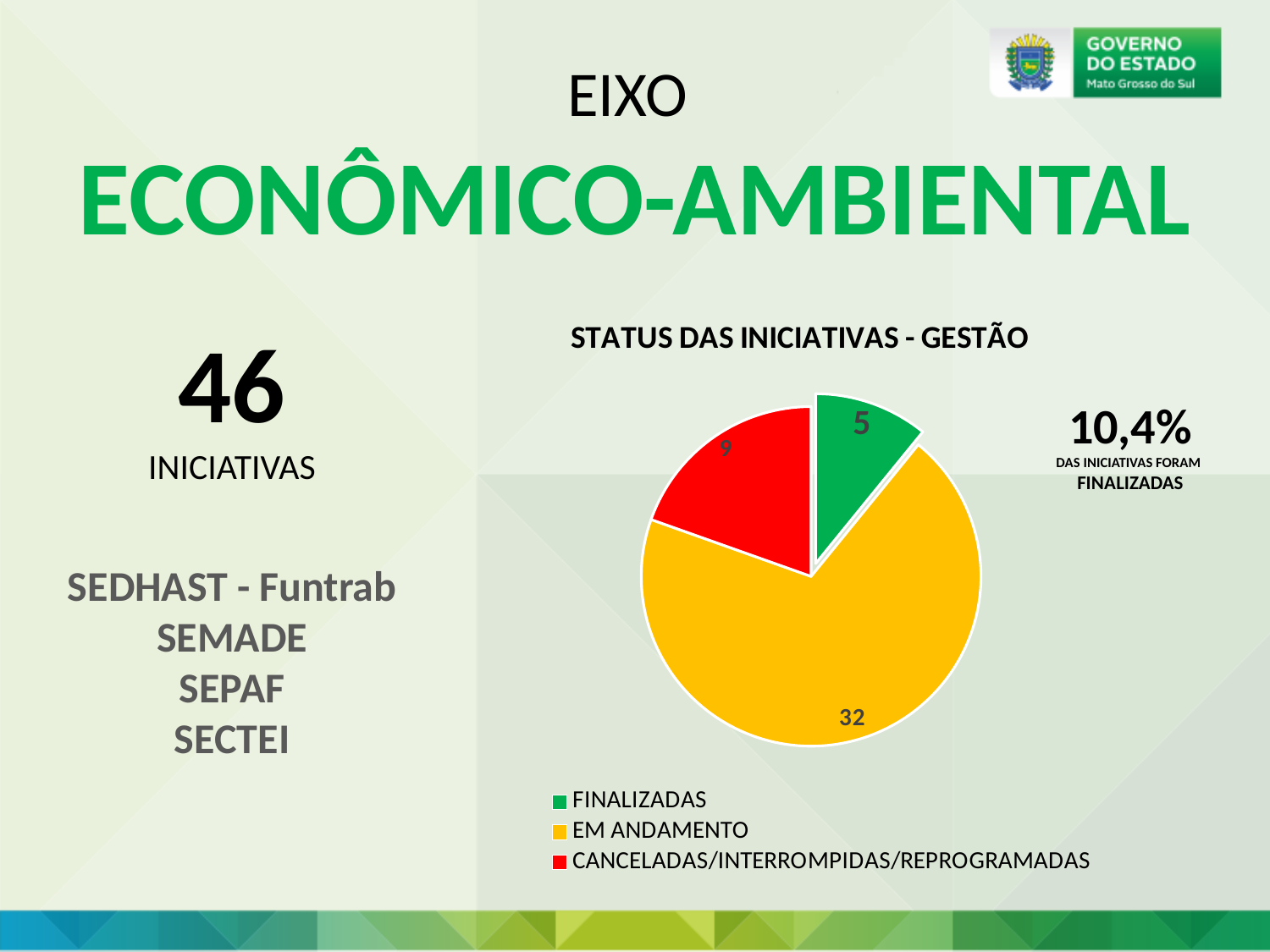
What colour represents EM ANDAMENTO in the pie chart? Yellow What type of chart is shown on the slide? Pie chart What is the difference between the CANCELADAS/INTERROMPIDAS/REPROGRAMADAS value and the FINALIZADAS value? 4 What is the value of the FINALIZADAS slice in the pie chart? 5 Which category has the largest slice in the pie chart? EM ANDAMENTO What is the difference between the EM ANDAMENTO value and the CANCELADAS/INTERROMPIDAS/REPROGRAMADAS value? 23 What is the title of the chart? STATUS DAS INICIATIVAS - GESTÃO Which category has the smallest slice in the pie chart? FINALIZADAS Which is larger, the FINALIZADAS slice or the CANCELADAS/INTERROMPIDAS/REPROGRAMADAS slice? CANCELADAS/INTERROMPIDAS/REPROGRAMADAS What is the value of the CANCELADAS/INTERROMPIDAS/REPROGRAMADAS slice in the pie chart? 9 What is the value of the EM ANDAMENTO slice in the pie chart? 32 How many categories does the pie chart show? 3